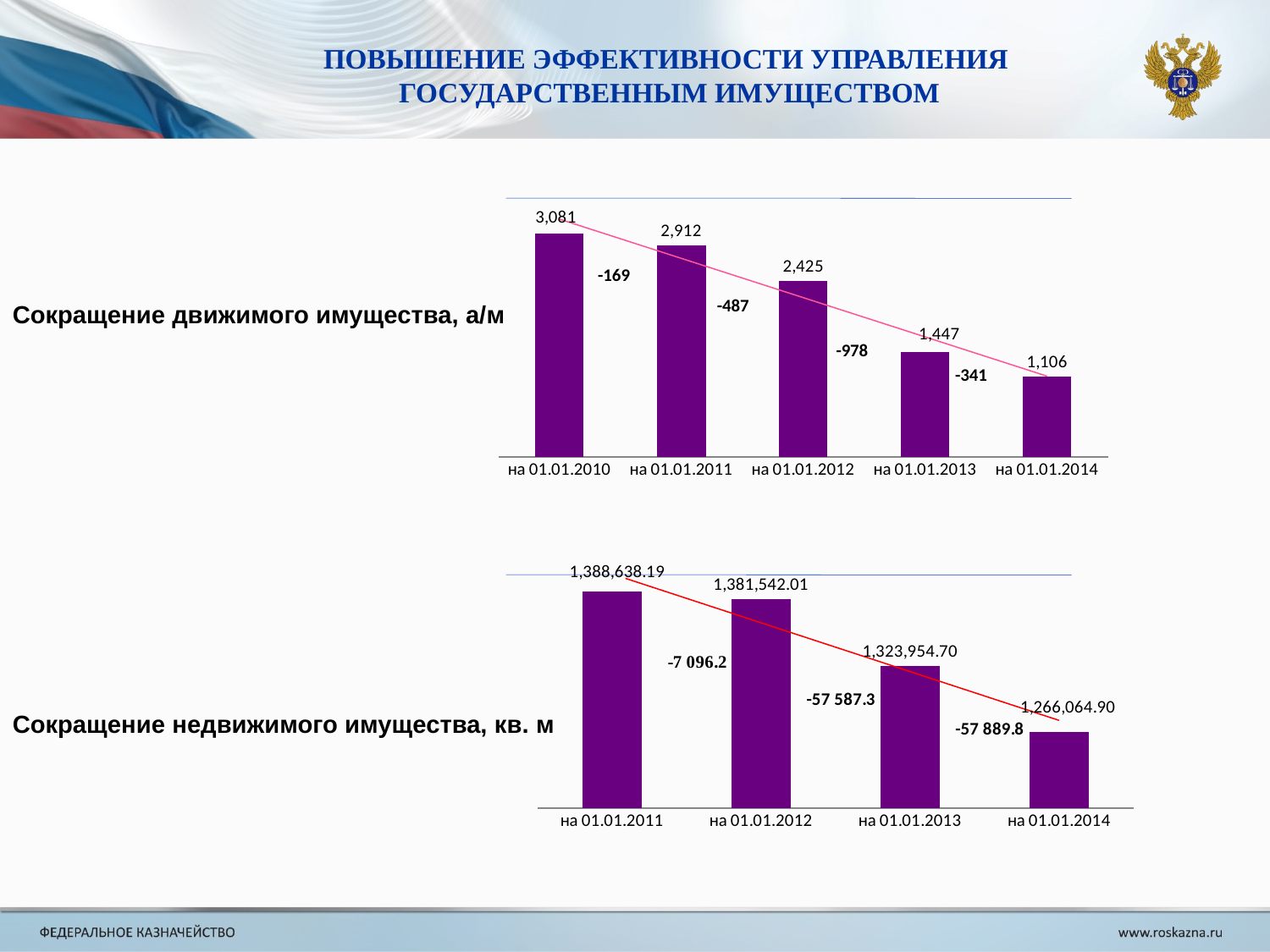
In the top chart (Сокращение движимого имущества, а/м), how many bars are plotted? 5 In the bottom chart (Сокращение недвижимого имущества, кв. м), what is the value for на 01.01.2012? 1,381,542.01 In the bottom chart (Сокращение недвижимого имущества, кв. м), which is larger: the value for на 01.01.2013 or на 01.01.2014? на 01.01.2013 In the bottom chart (Сокращение недвижимого имущества, кв. м), how many bars are plotted? 4 In the top chart (Сокращение движимого имущества, а/м), which date has the lowest value? на 01.01.2014 In the bottom chart (Сокращение недвижимого имущества, кв. м), what is the value for на 01.01.2014? 1,266,064.90 In the top chart (Сокращение движимого имущества, а/м), what is the value for на 01.01.2013? 1,447 In the top chart (Сокращение движимого имущества, а/м), do the values rise or fall from left to right? fall In the top chart (Сокращение движимого имущества, а/м), what is the difference between the values for на 01.01.2011 and на 01.01.2012? 487 In the top chart (Сокращение движимого имущества, а/м), what is the value for на 01.01.2010? 3,081 What type of chart is the top chart (Сокращение движимого имущества, а/м)? bar chart In the bottom chart (Сокращение недвижимого имущества, кв. м), which date has the highest value? на 01.01.2011